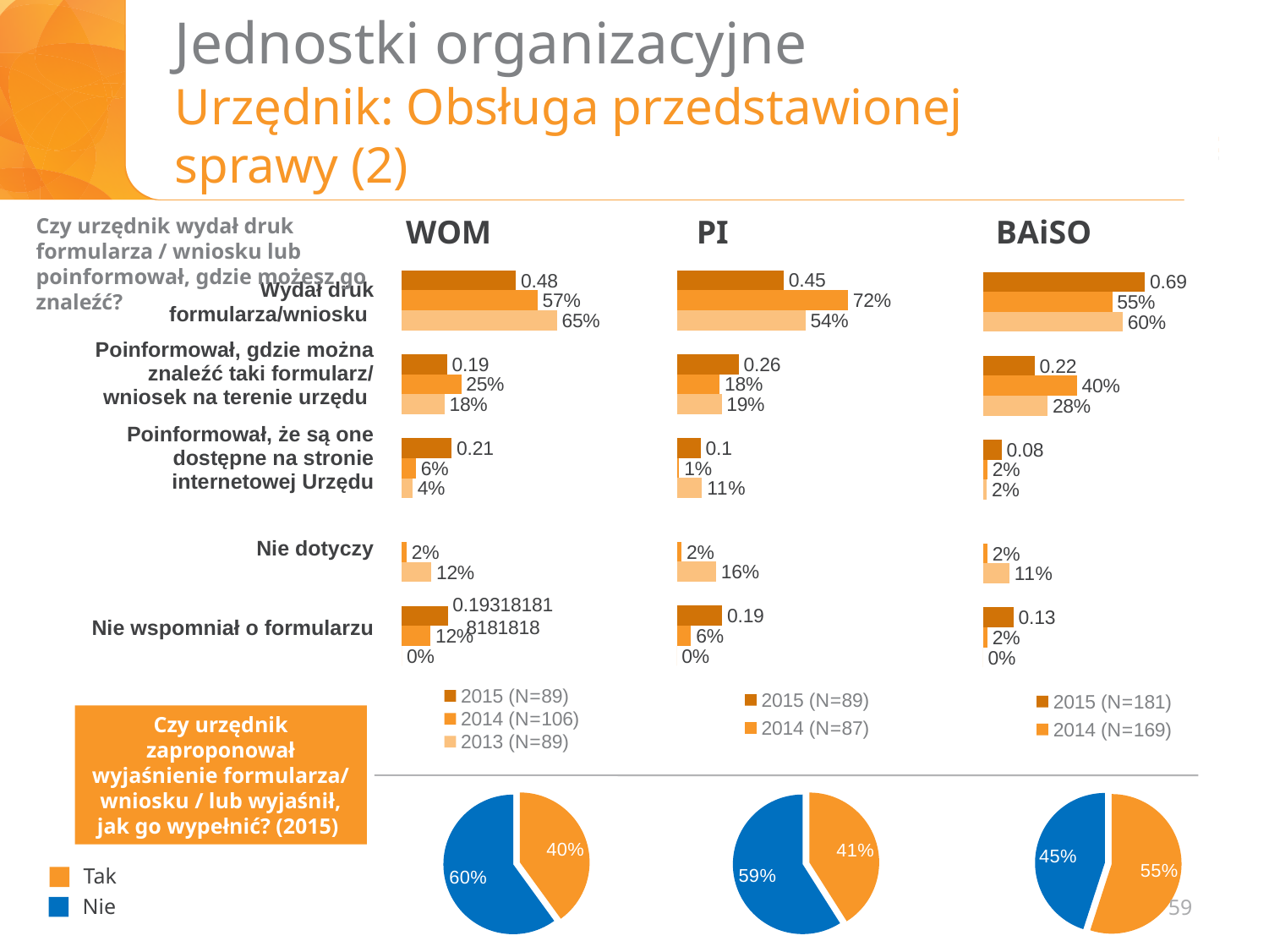
In the BAiSO pie chart (bottom right), what share is 'Tak'? 55% In the BAiSO bar chart, how many series does the legend list? 2 In the WOM bar chart, what is the 2014 value for 'Poinformował, że są one dostępne na stronie internetowej Urzędu'? 6% In the BAiSO bar chart, what is the 2014 value for 'Poinformował, gdzie można znaleźć taki formularz/wniosek na terenie urzędu'? 40% In the WOM bar chart, what is the 2013 value for 'Wydał druk formularza/wniosku'? 65% In the PI bar chart, what is the difference between the 2014 and 2013 values for 'Wydał druk formularza/wniosku'? 18% In the WOM pie chart (bottom left), what share is 'Nie'? 60% What kind of chart is used for the WOM, PI and BAiSO data in the upper part of the slide? Bar chart In the PI bar chart, what is the 2014 value for 'Wydał druk formularza/wniosku'? 72% In the BAiSO bar chart, what is the 2015 value for 'Wydał druk formularza/wniosku'? 0.69 In the WOM bar chart, how many series does the legend list? 3 In the PI pie chart (bottom middle), which slice is larger, 'Tak' or 'Nie'? Nie